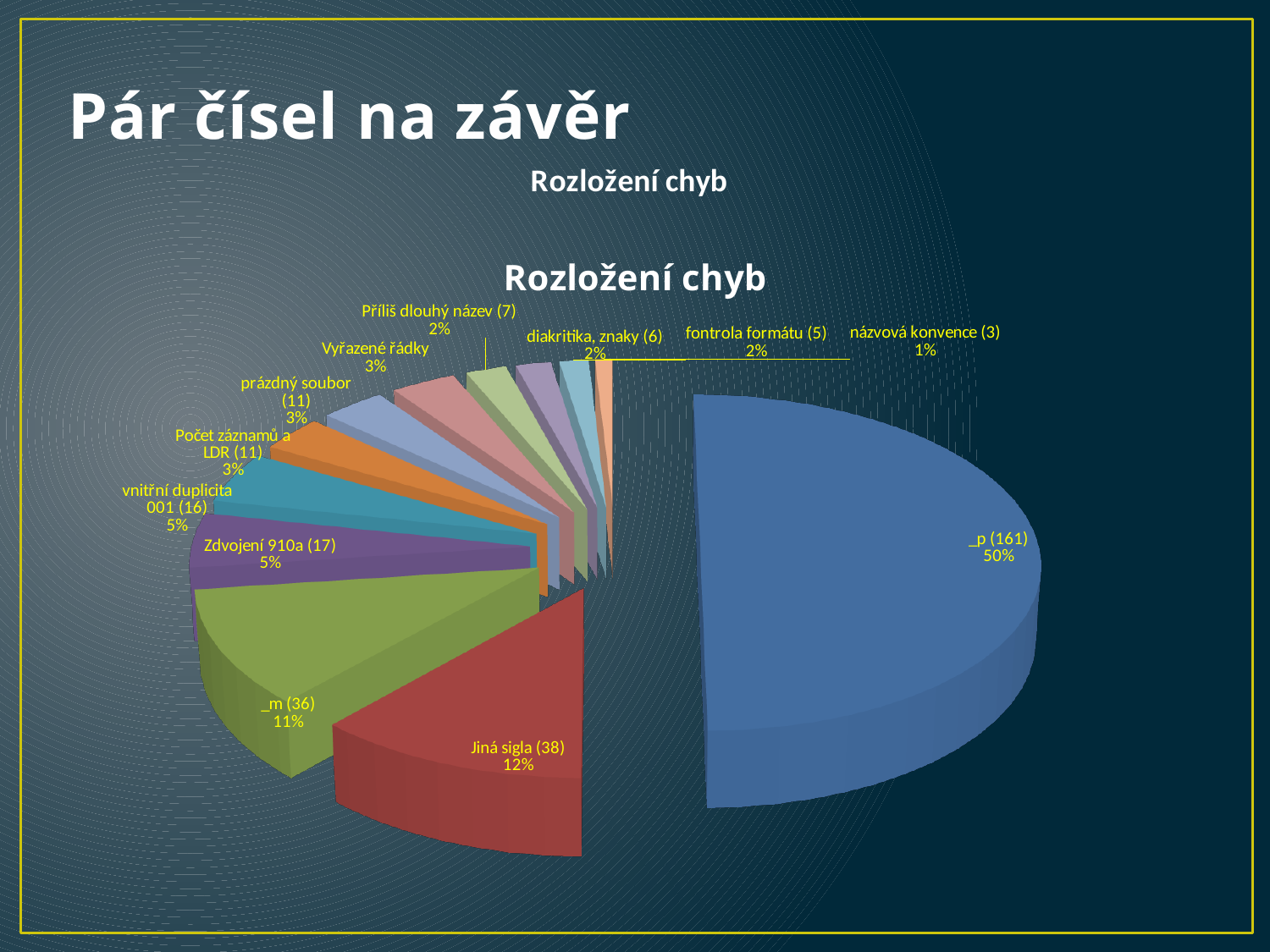
Which category has the smallest slice of the pie? názvová konvence (3) What share of the pie does the _m (36) slice represent? 11% Which category has the largest slice of the pie? _p (161) What share of the pie does the Zdvojení 910a (17) slice represent? 5% What share of the pie does the _p (161) slice represent? 50% What is the difference in percentage points between the _p (161) slice and the Jiná sigla (38) slice? 38 Which slice is larger, Jiná sigla (38) or _m (36)? Jiná sigla (38) What kind of chart is shown on the slide? pie chart What is the title of the chart? Rozložení chyb How many slices does the pie chart have? 12